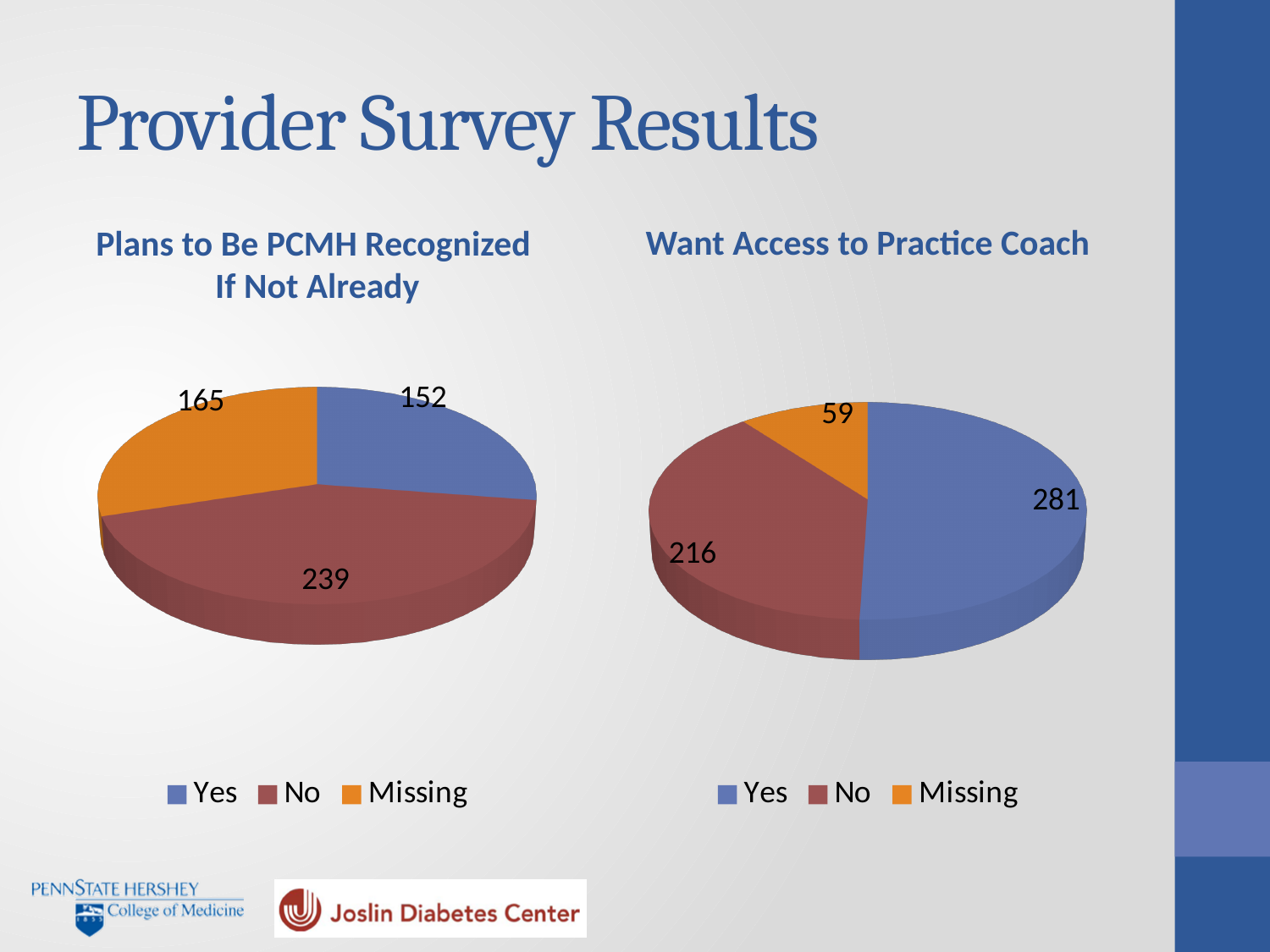
In the 'Want Access to Practice Coach' chart, what is the value for Yes? 281 What is the total of all slices in the 'Want Access to Practice Coach' chart? 556 What colour represents Missing in the legend of the 'Plans to Be PCMH Recognized If Not Already' chart? Orange How many categories does the 'Plans to Be PCMH Recognized If Not Already' chart show? 3 In the 'Want Access to Practice Coach' chart, what is the value for Missing? 59 In the 'Plans to Be PCMH Recognized If Not Already' chart, which category has the largest slice? No In the 'Plans to Be PCMH Recognized If Not Already' chart, which is larger, Yes or Missing? Missing In the 'Want Access to Practice Coach' chart, what is the difference between Yes and No? 65 In the 'Plans to Be PCMH Recognized If Not Already' chart, what is the value for No? 239 What type of chart is the 'Want Access to Practice Coach' chart? Pie chart In the 'Plans to Be PCMH Recognized If Not Already' chart, what is the difference between No and Yes? 87 In the 'Want Access to Practice Coach' chart, which category has the smallest slice? Missing